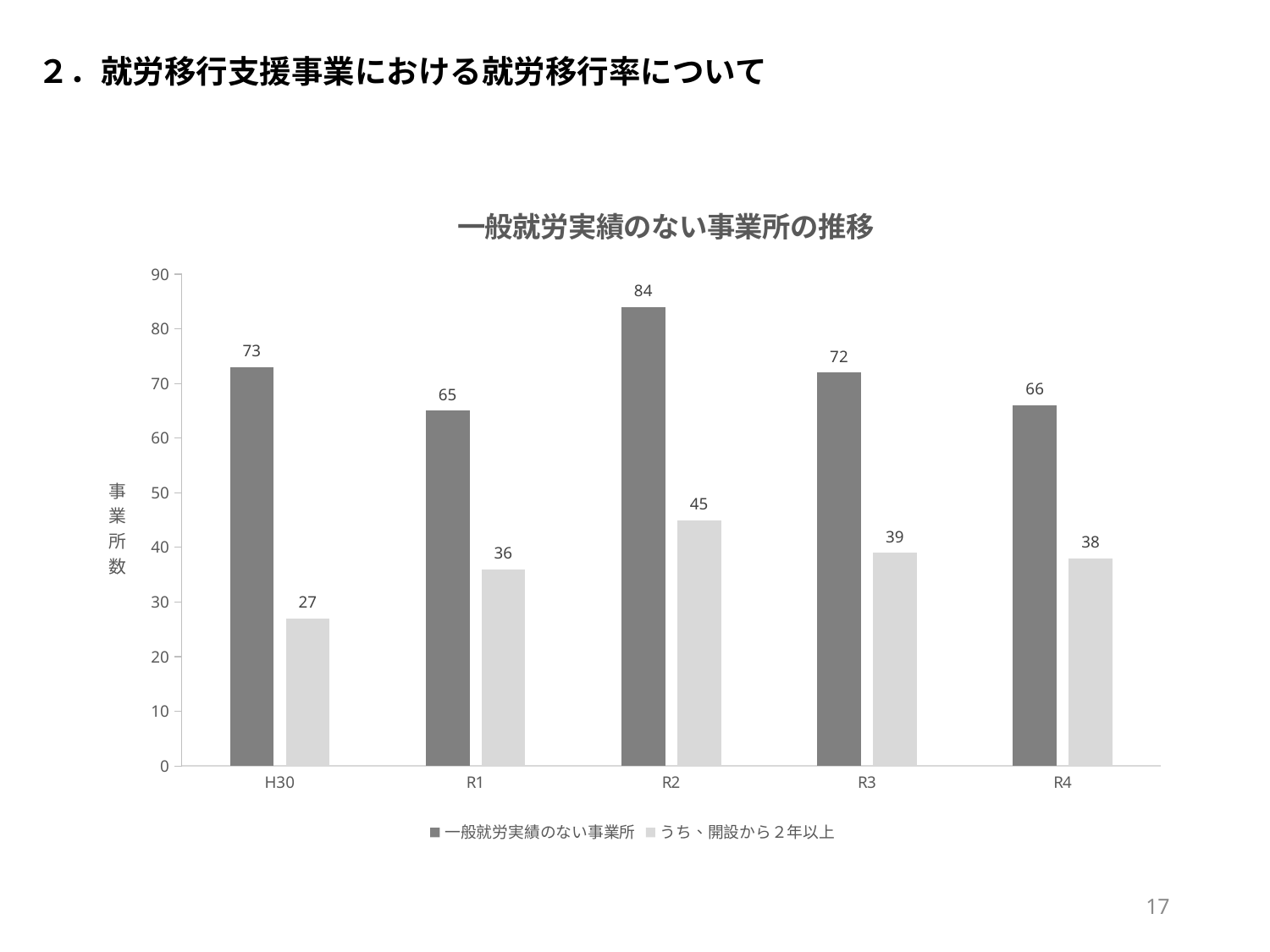
Which year has the highest value for 一般就労実績のない事業所? R2 How many series does the legend list? 2 Which is larger: the value for 一般就労実績のない事業所 in H30 or in R3? H30 Is the value for うち、開設から２年以上 in R2 greater or less than 40? greater Does the value for うち、開設から２年以上 rise or fall from H30 to R2? rise What kind of chart is shown? bar chart What is the difference between 一般就労実績のない事業所 and うち、開設から２年以上 in R4? 28 What is the title of the chart? 一般就労実績のない事業所の推移 What is the value for 一般就労実績のない事業所 in R2? 84 What is the value for うち、開設から２年以上 in H30? 27 Which year has the lowest value for うち、開設から２年以上? H30 How many years are shown on the x axis? 5